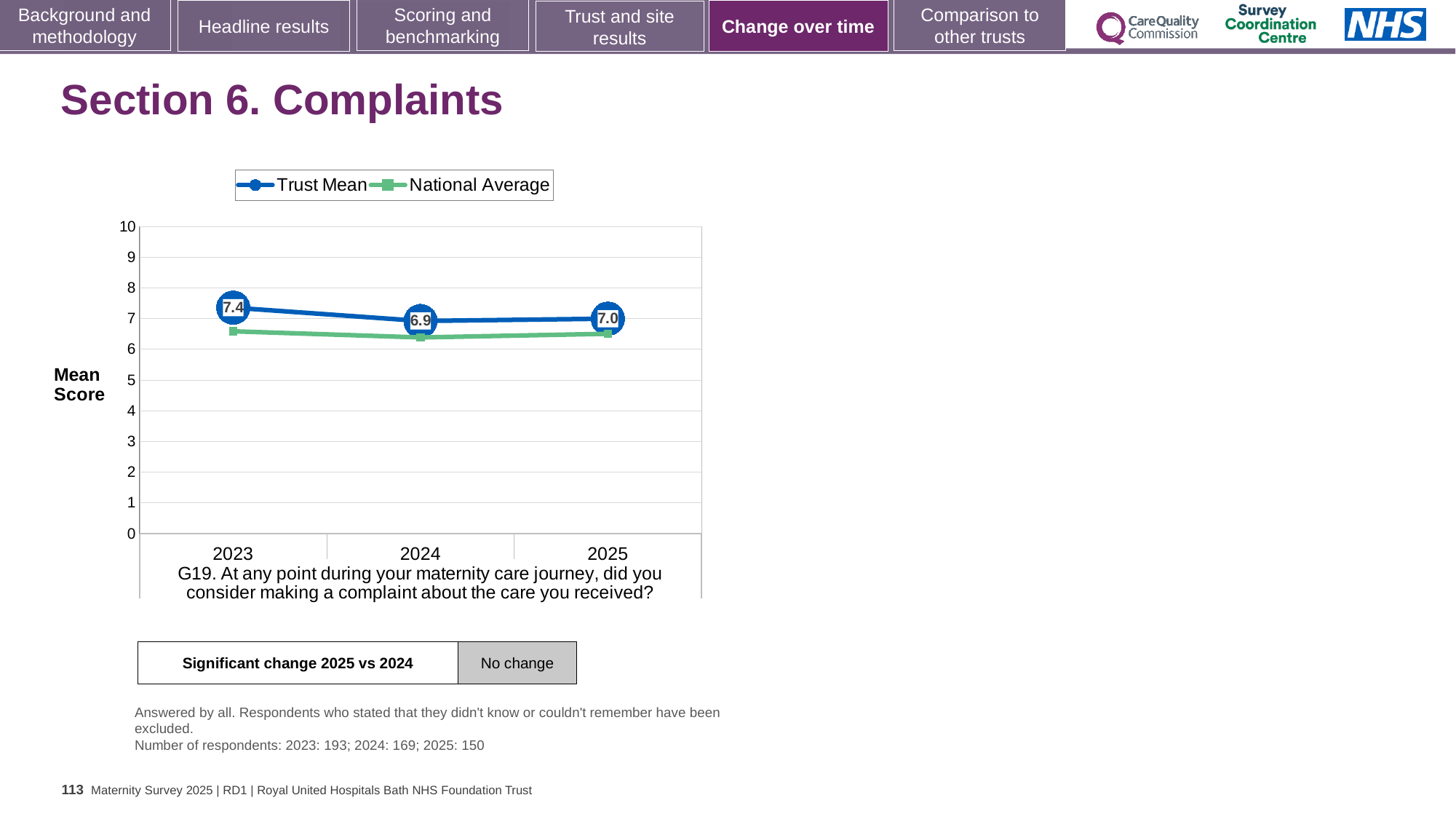
Is the National Average value for 2024 greater or less than 6? greater How many years are shown on the x axis? 3 What is the Trust Mean score for 2023? 7.4 In which year is the Trust Mean highest? 2023 Which is larger, the Trust Mean in 2023 or the Trust Mean in 2025? 2023 How many series does the legend list? 2 What is the difference between the Trust Mean in 2023 and in 2024? 0.5 What is the Trust Mean score for 2024? 6.9 In which year is the Trust Mean lowest? 2024 Is the National Average value for 2023 greater or less than 7? less What kind of chart is shown on the slide? line chart What is the Trust Mean score for 2025? 7.0